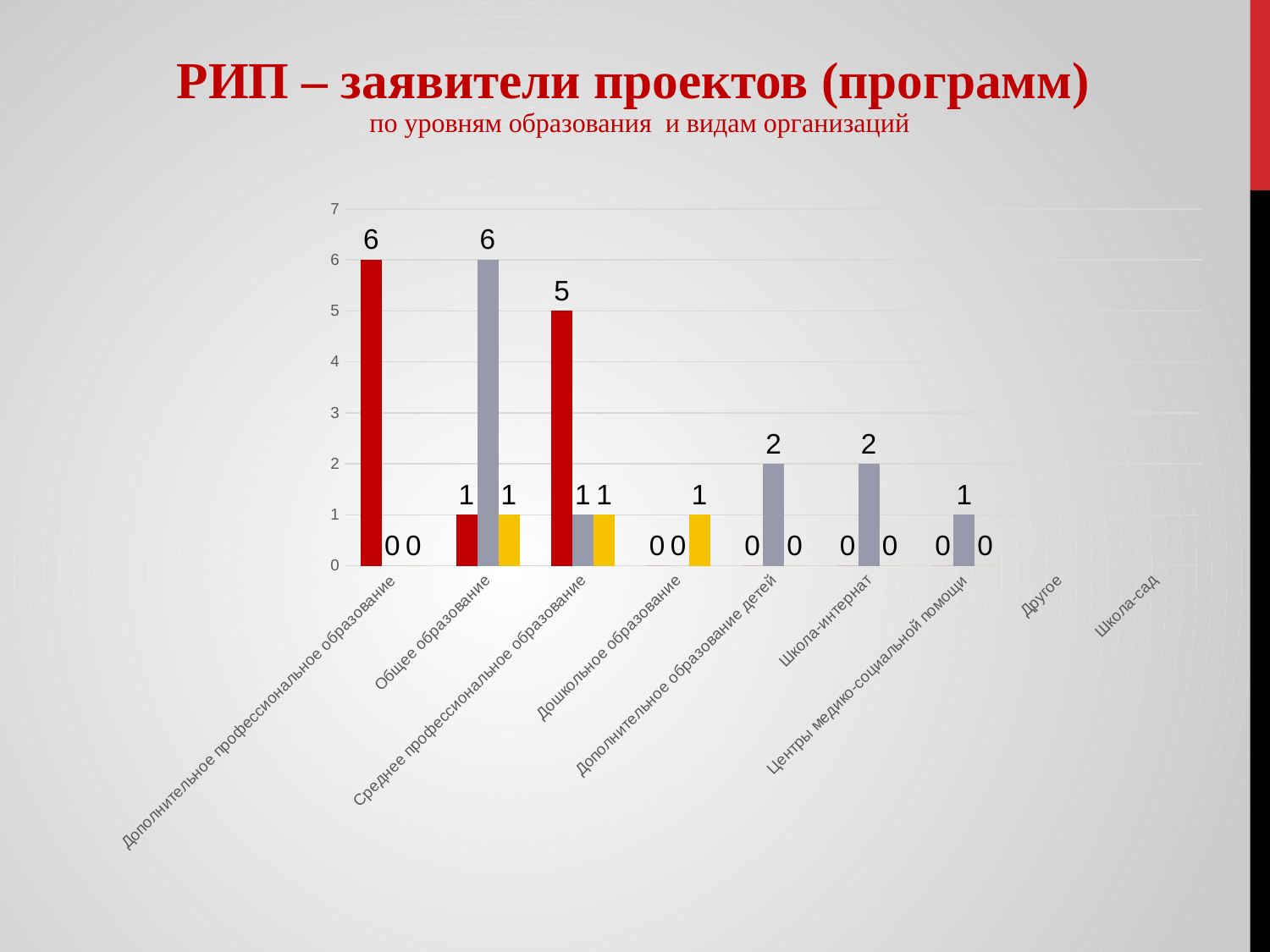
What is the value of the red bar for Дополнительное профессиональное образование? 6 How many categories are shown on the x axis? 9 What is the value of the grey bar for Школа-интернат? 2 Which is larger: the grey bar for Дополнительное образование детей or the grey bar for Центры медико-социальной помощи? Дополнительное образование детей What is the value of the grey bar for Центры медико-социальной помощи? 1 What is the value of the yellow bar for Дошкольное образование? 1 Which category has the highest grey bar? Общее образование What is the value of the red bar for Среднее профессиональное образование? 5 What type of chart is shown on the slide? Bar chart Which category has the highest red bar? Дополнительное профессиональное образование What is the value of the grey bar for Общее образование? 6 What is the difference between the red bar for Дополнительное профессиональное образование and the red bar for Среднее профессиональное образование? 1